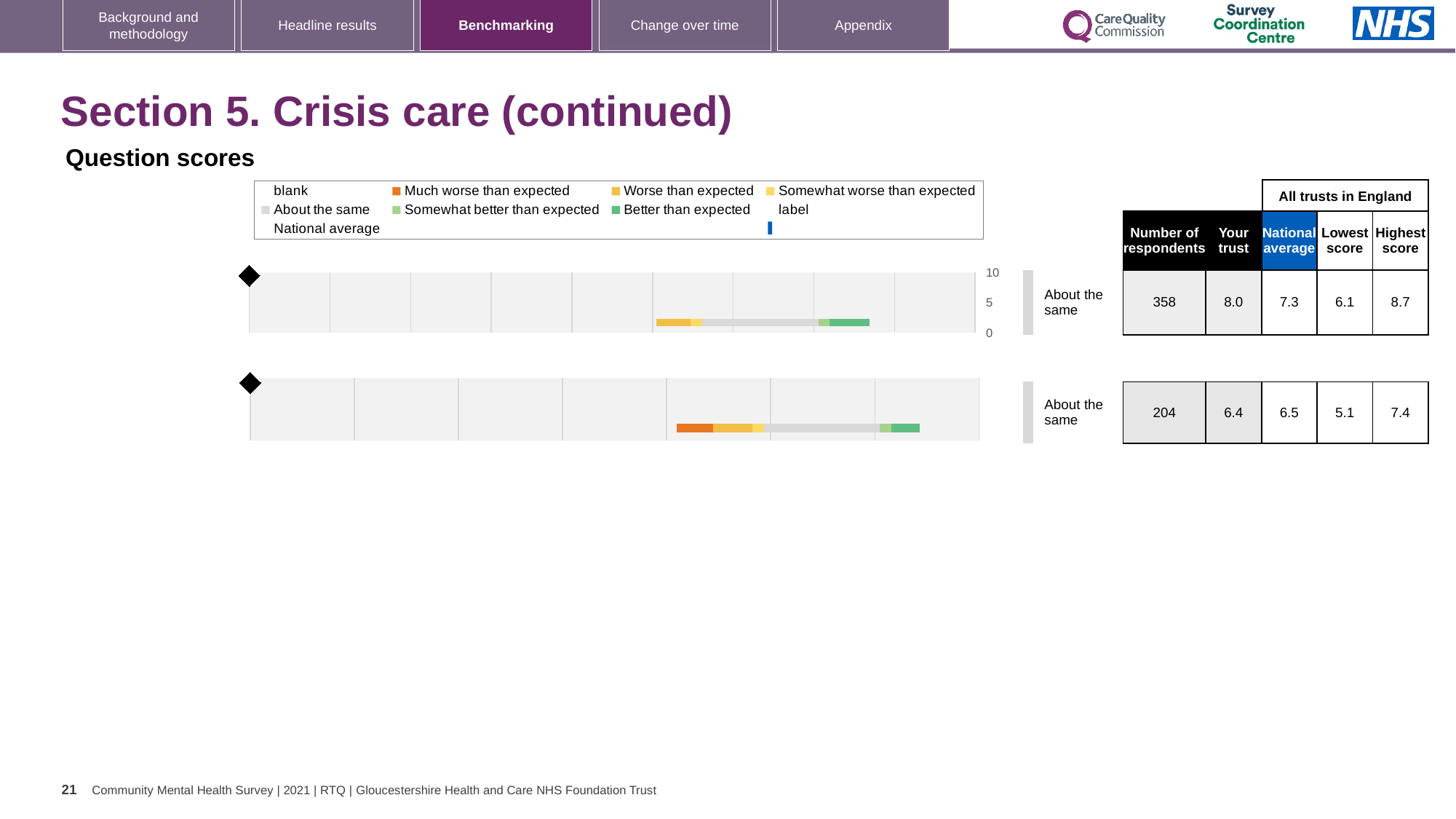
What kind of chart is used to show the question scores on this slide? Bar chart On the bottom chart, what is the highest score among all trusts in England? 7.4 On the top chart, what is the score for 'Your trust'? 8.0 On the top chart, what is the difference between the 'Your trust' score and the national average? 0.7 On the top chart, is the 'Your trust' score greater or less than 5? greater How many question score charts are shown on the slide? 2 On the bottom chart, which is larger: the 'Your trust' score or the national average? National average In the legend, which colour represents 'Much worse than expected'? Orange On the top chart, what is the national average score? 7.3 On the bottom chart, what is the difference between the highest score and the lowest score? 2.3 On the top chart, what is the lowest score among all trusts in England? 6.1 On the bottom chart, how many respondents are there? 204